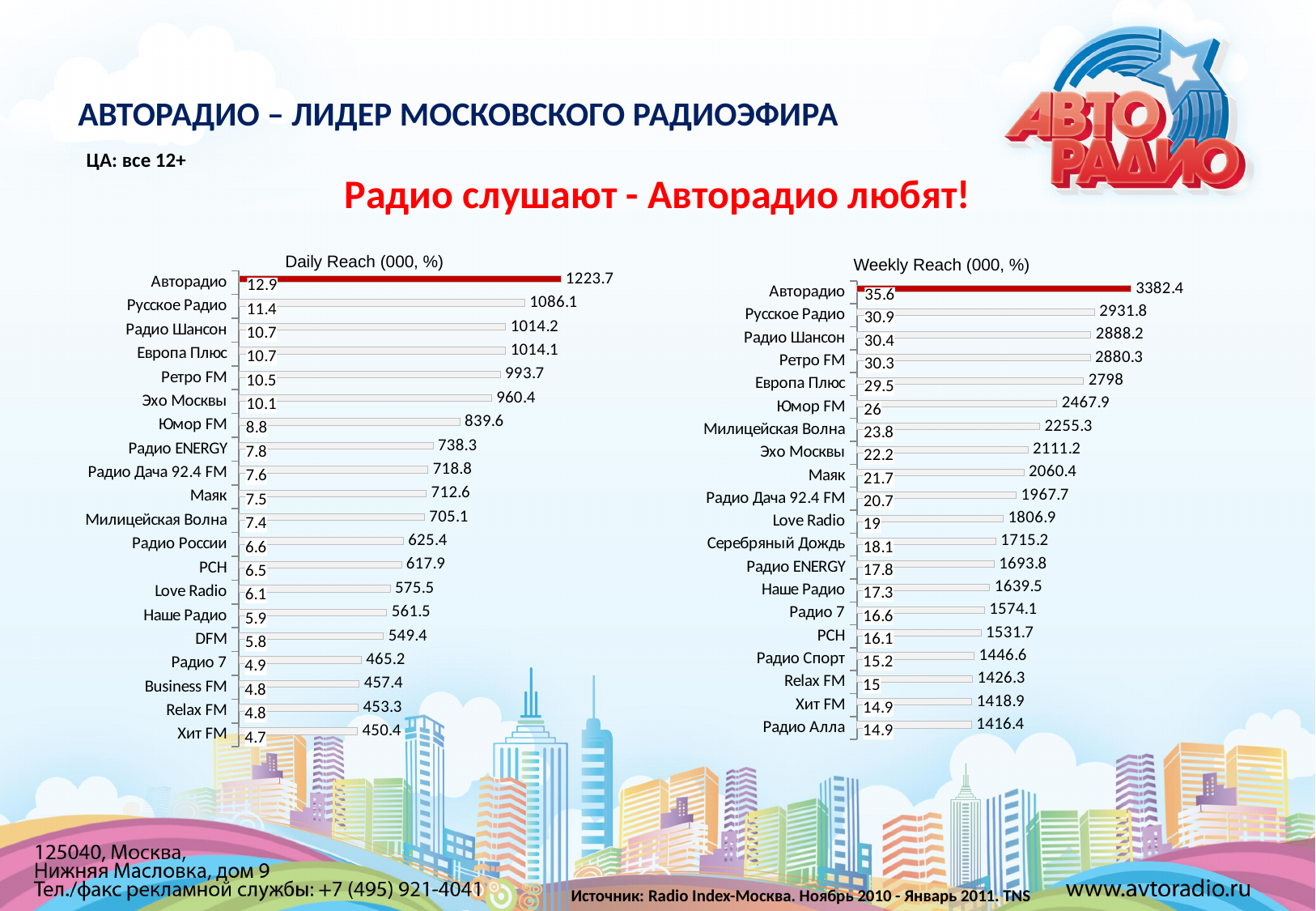
In the Weekly Reach (000, %) chart, what percentage is shown for Серебряный Дождь? 18.1 In the Daily Reach (000, %) chart, what is the difference in thousands between Авторадио and Русское Радио? 137.6 In the Weekly Reach (000, %) chart, what is the difference in thousands between Авторадио and Русское Радио? 450.6 In the Weekly Reach (000, %) chart, what is the reach in thousands for Юмор FM? 2467.9 In the Daily Reach (000, %) chart, which station has the lowest reach? Хит FM What type of chart is the Weekly Reach (000, %) chart? Bar chart In the Daily Reach (000, %) chart, which station's bar is highlighted in red? Авторадио In the Daily Reach (000, %) chart, what is the reach in thousands for Авторадио? 1223.7 In the Weekly Reach (000, %) chart, which has the larger reach, Маяк or Love Radio? Маяк In the Weekly Reach (000, %) chart, which station has the highest reach? Авторадио How many stations are listed in the Daily Reach (000, %) chart? 20 In the Daily Reach (000, %) chart, what percentage is shown for Эхо Москвы? 10.1